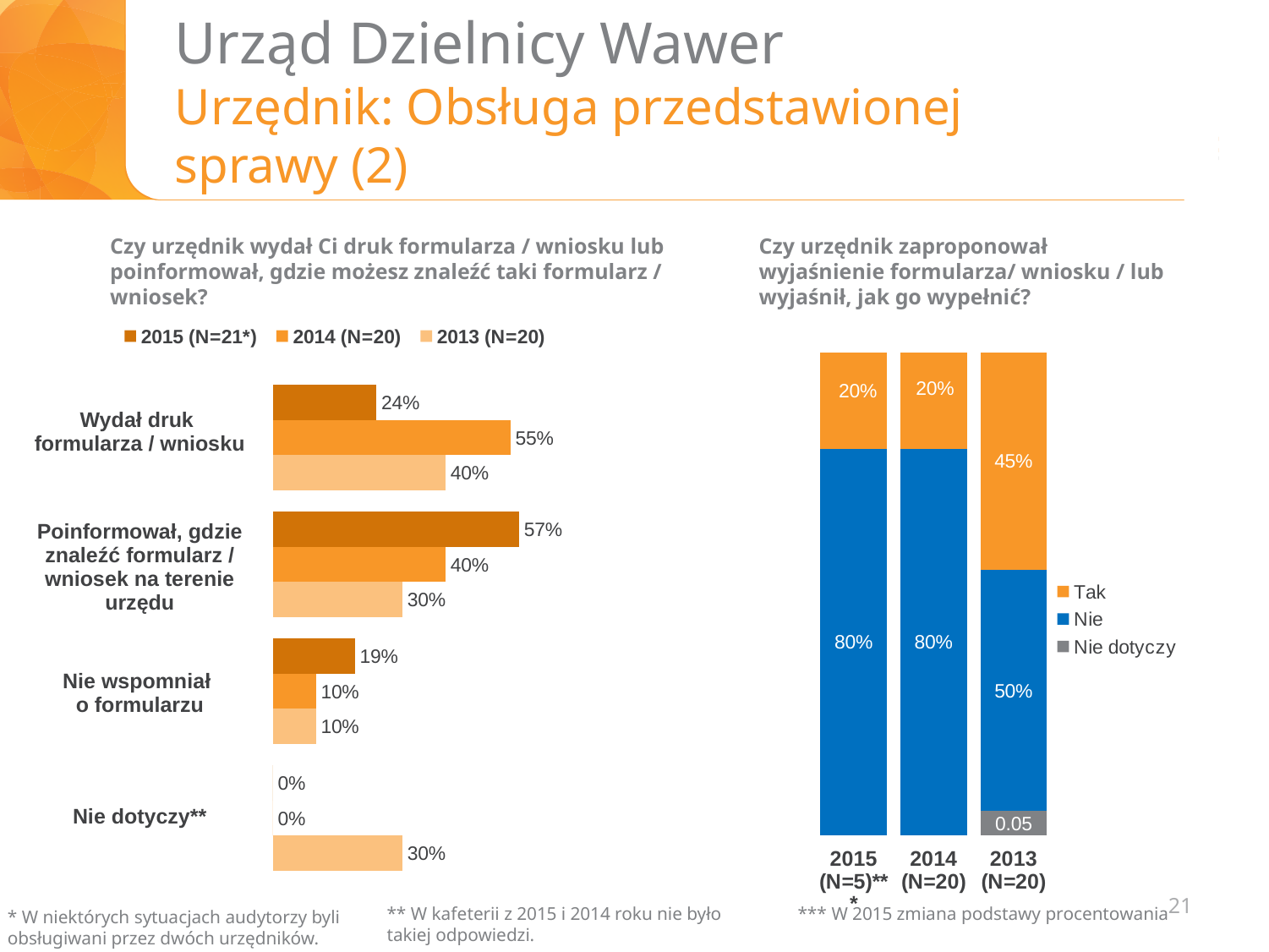
What type of chart is the right chart ("Czy urzędnik zaproponował wyjaśnienie formularza...")? Stacked bar chart How many categories are shown in the left chart? 4 In the left chart, which is larger for "Nie wspomniał o formularzu": the 2015 value or the 2014 value? 2015 In the right chart, what is the "Tak" value for 2013 (N=20)? 45% In the left chart, which category has the highest 2015 (N=21*) value? Poinformował, gdzie znaleźć formularz / wniosek na terenie urzędu In the right chart, what is the "Nie dotyczy" value shown for 2013 (N=20)? 0.05 In the right chart, what is the "Nie" value for 2015 (N=5)**? 80% In the left chart ("Czy urzędnik wydał Ci druk formularza / wniosku..."), what is the value for "Wydał druk formularza / wniosku" in 2014 (N=20)? 55% How many series does the legend of the left chart list? 3 In the left chart, what is the 2013 (N=20) value for "Nie dotyczy**"? 30% In the left chart, what is the difference between the 2014 and 2015 values for "Wydał druk formularza / wniosku"? 31 percentage points In the left chart, what is the 2015 (N=21*) value for "Poinformował, gdzie znaleźć formularz / wniosek na terenie urzędu"? 57%